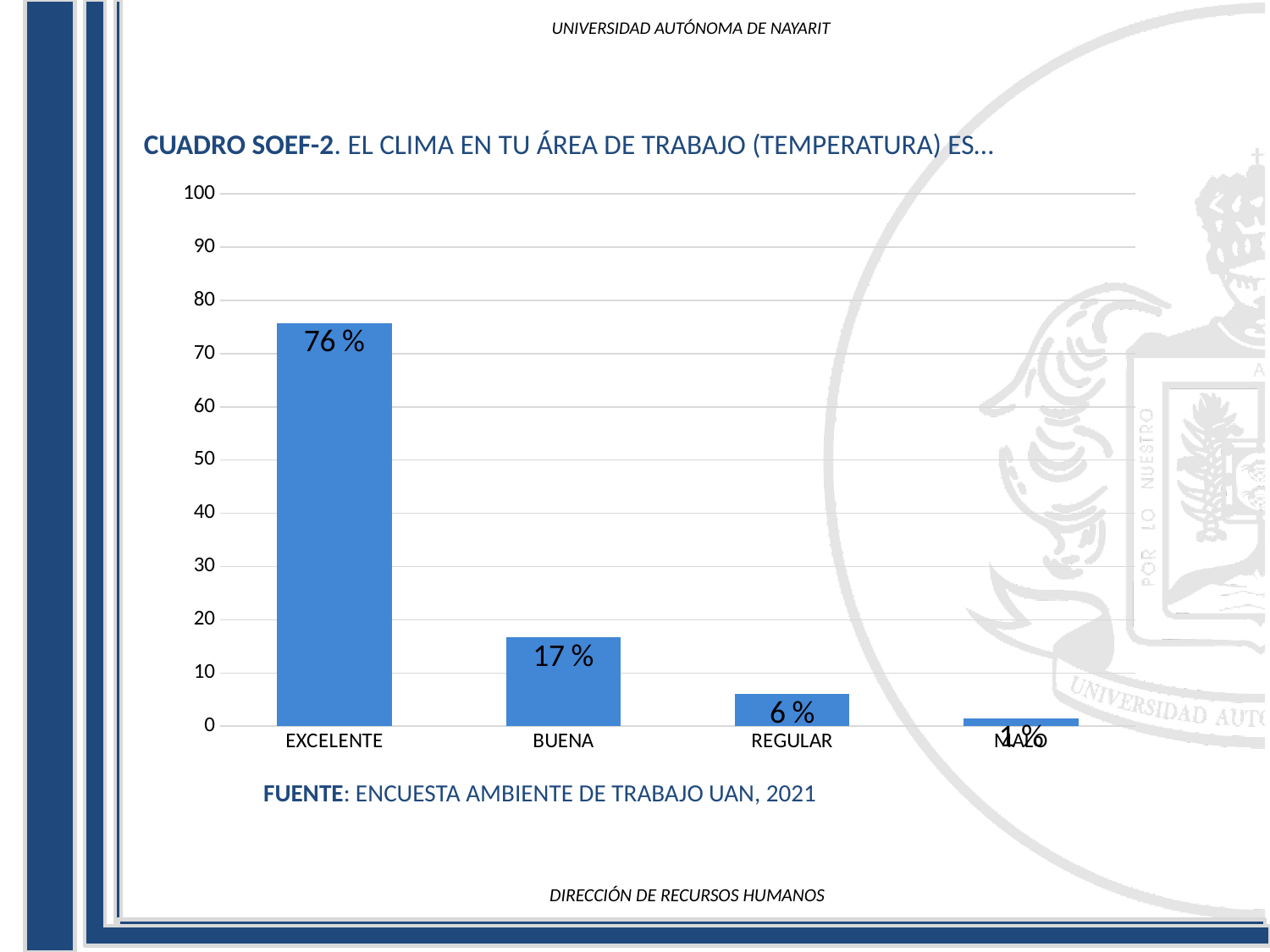
What is the value for BUENA? 17 % What is the value for EXCELENTE? 76 % How many categories are shown on the x axis? 4 Which is larger, the value for BUENA or the value for REGULAR? BUENA What kind of chart is shown on the slide? bar chart What is the difference between the values for BUENA and REGULAR? 11 % Do the values rise or fall from left to right along the x axis? fall What is the difference between the values for EXCELENTE and BUENA? 59 % Is the value for EXCELENTE greater or less than 70? greater Which category has the lowest value? MALO What is the value for REGULAR? 6 % Which category has the highest value? EXCELENTE